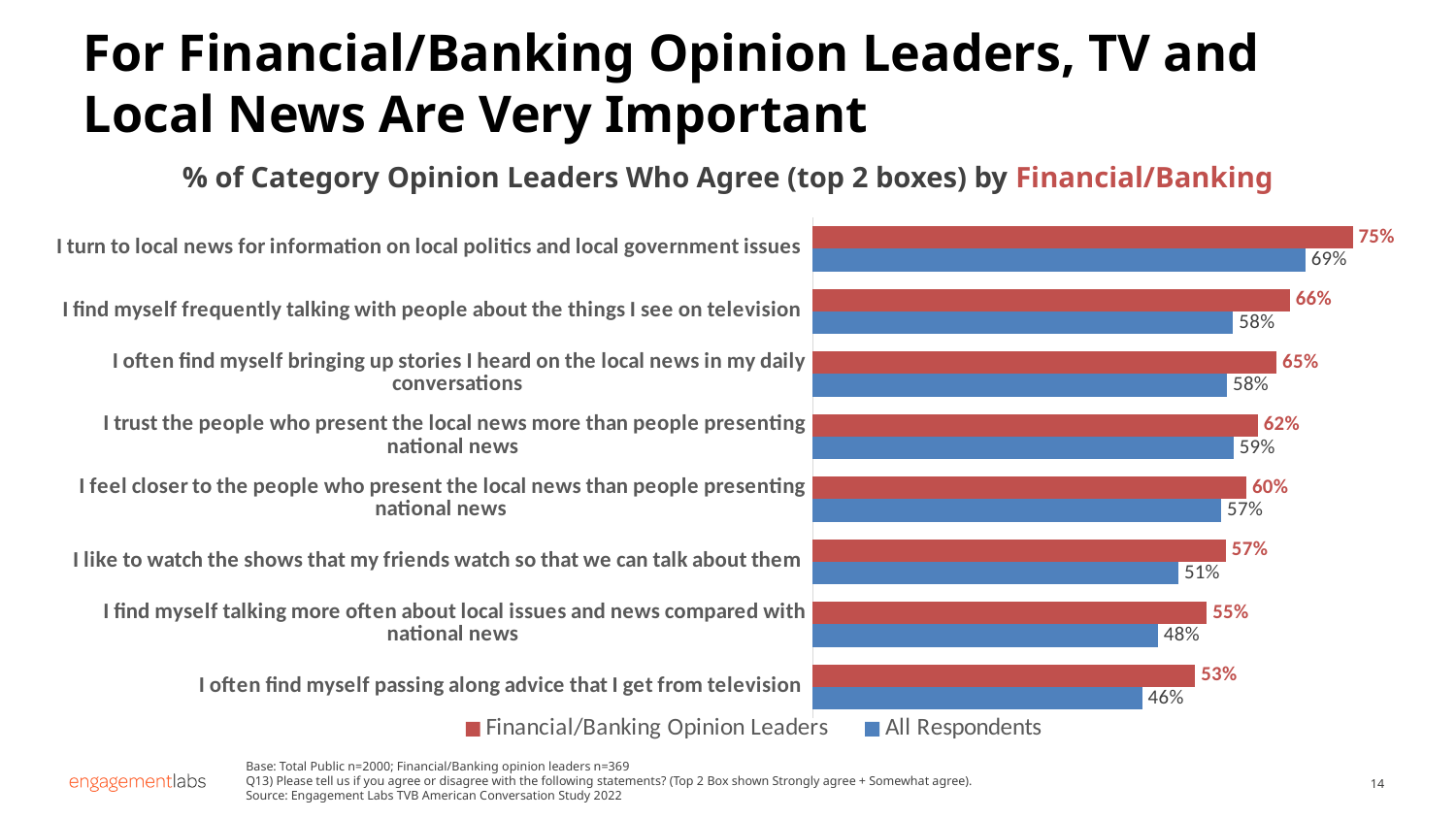
What is the difference between Financial/Banking Opinion Leaders and All Respondents for "I find myself talking more often about local issues and news compared with national news"? 7% How many statements are shown in the chart? 8 How many series does the legend list? 2 Which statement has the highest value for Financial/Banking Opinion Leaders? I turn to local news for information on local politics and local government issues What kind of chart is shown on the slide? Bar chart Which statement has the lowest value for All Respondents? I often find myself passing along advice that I get from television For "I trust the people who present the local news more than people presenting national news", which group has the larger value: Financial/Banking Opinion Leaders or All Respondents? Financial/Banking Opinion Leaders What percentage of All Respondents agree with "I often find myself passing along advice that I get from television"? 46% Which colour represents All Respondents in the chart? Blue What is the difference between Financial/Banking Opinion Leaders and All Respondents for "I find myself frequently talking with people about the things I see on television"? 8% What is the All Respondents value for "I like to watch the shows that my friends watch so that we can talk about them"? 51% What percentage of Financial/Banking Opinion Leaders agree with "I turn to local news for information on local politics and local government issues"? 75%